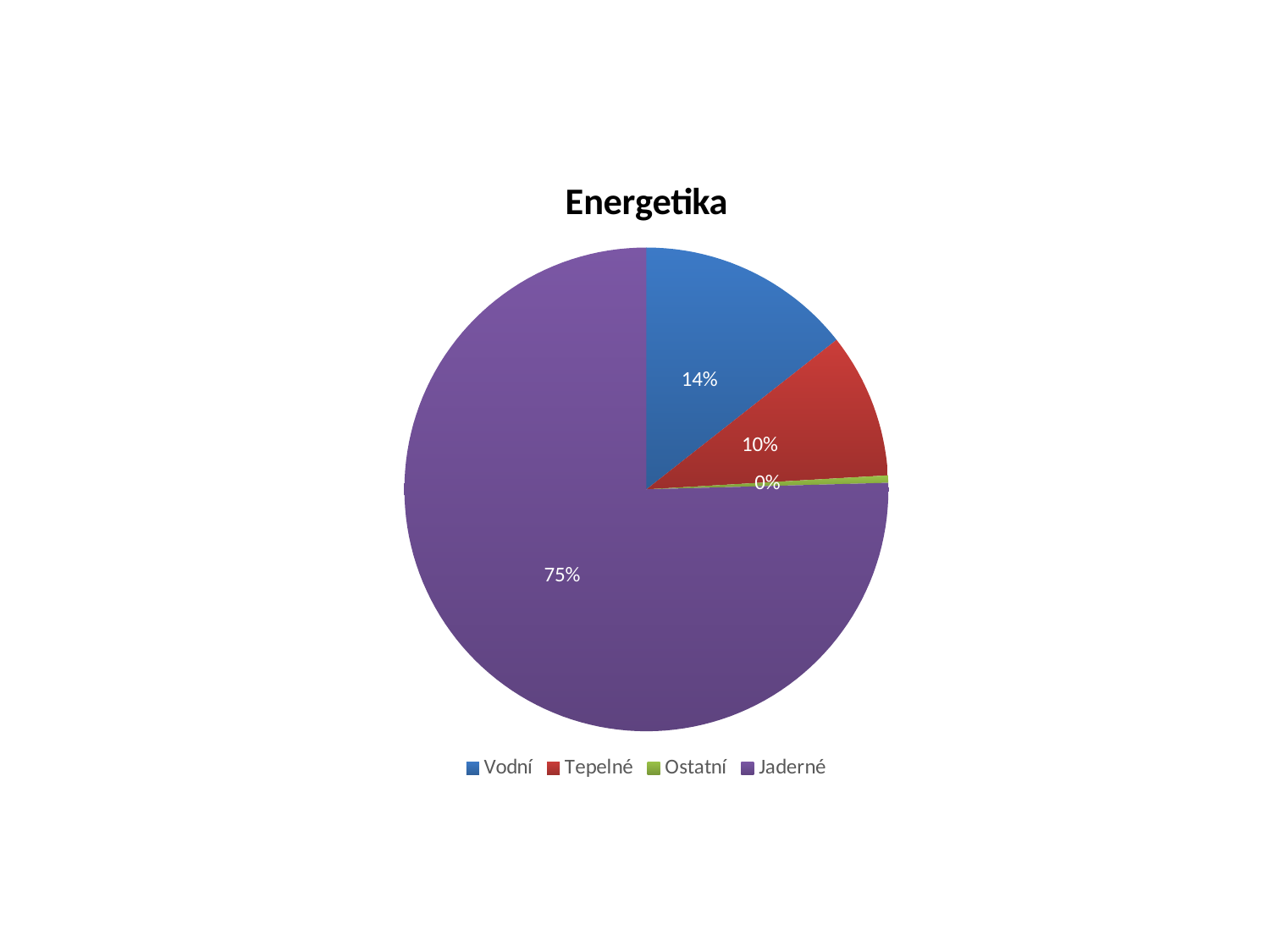
What is the difference between the share for Jaderné and the share for Vodní? 61% Which colour represents Tepelné in the legend? red What kind of chart is shown on the slide? pie chart What share of the pie does Jaderné take? 75% What share of the pie does Tepelné take? 10% Which category has the smallest slice of the pie? Ostatní What is the title of the chart? Energetika Which category has the largest slice of the pie? Jaderné How many categories does the pie chart show? 4 What share of the pie does Vodní take? 14% Which is larger, the share for Vodní or the share for Tepelné? Vodní